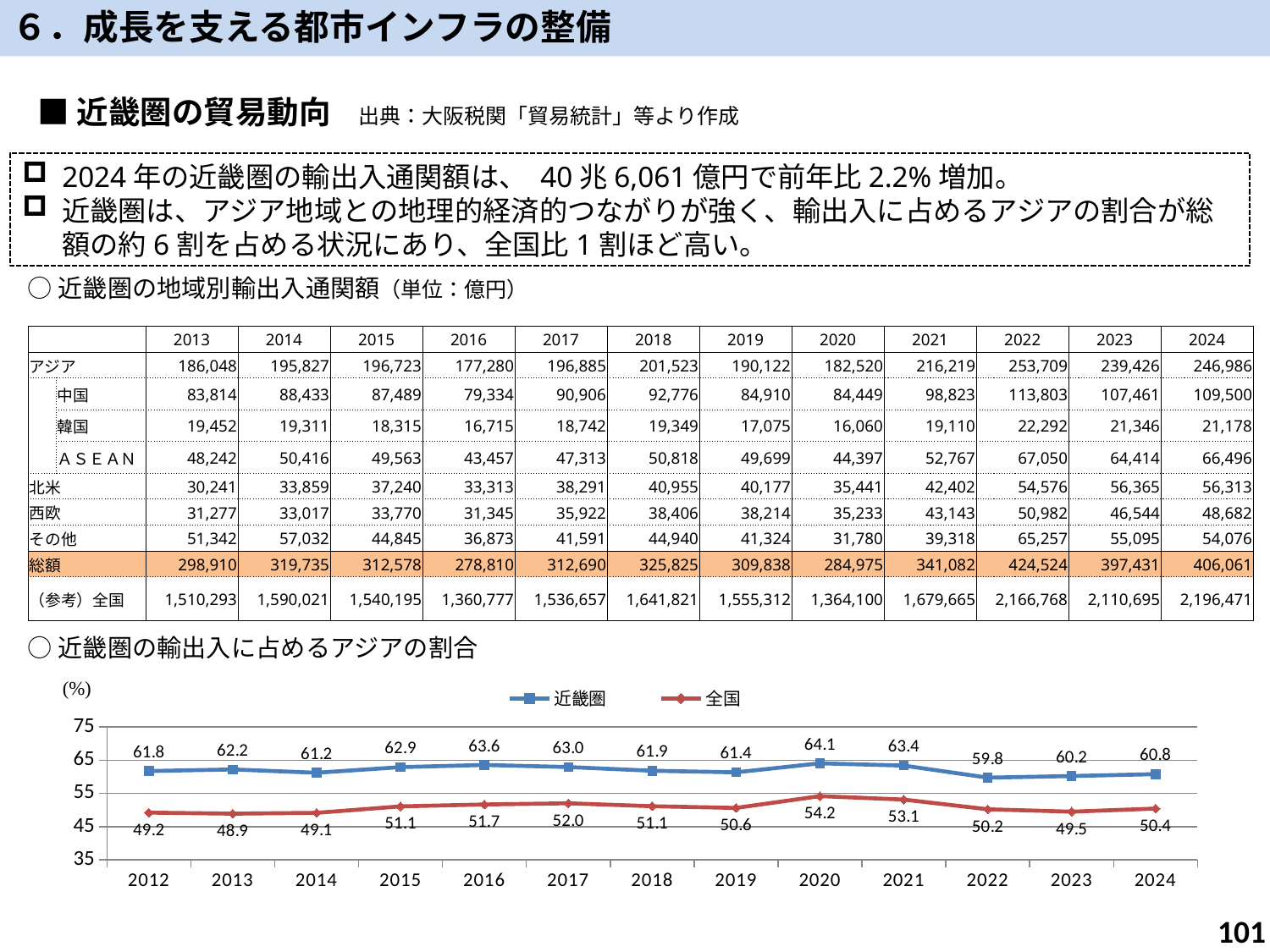
In the line chart, what is the difference between the 近畿圏 and 全国 values in 2024? 10.4 In the line chart, in which year is the 近畿圏 value highest? 2020 In the line chart, in which year is the 近畿圏 value lowest? 2022 What type of chart is shown under the heading 近畿圏の輸出入に占めるアジアの割合? line chart In the line chart, which colour is used for the 全国 series? red In the line chart, what is the value for 全国 in 2020? 54.2 In the line chart, how many series does the legend list? 2 In the line chart, in which year is the 全国 value lowest? 2013 In the line chart, what is the value for 近畿圏 in 2024? 60.8 In the line chart, which series has the larger value in 2016, 近畿圏 or 全国? 近畿圏 In the line chart, does the 近畿圏 value rise or fall from 2021 to 2022? fall In the line chart, how many years are plotted along the x axis? 13